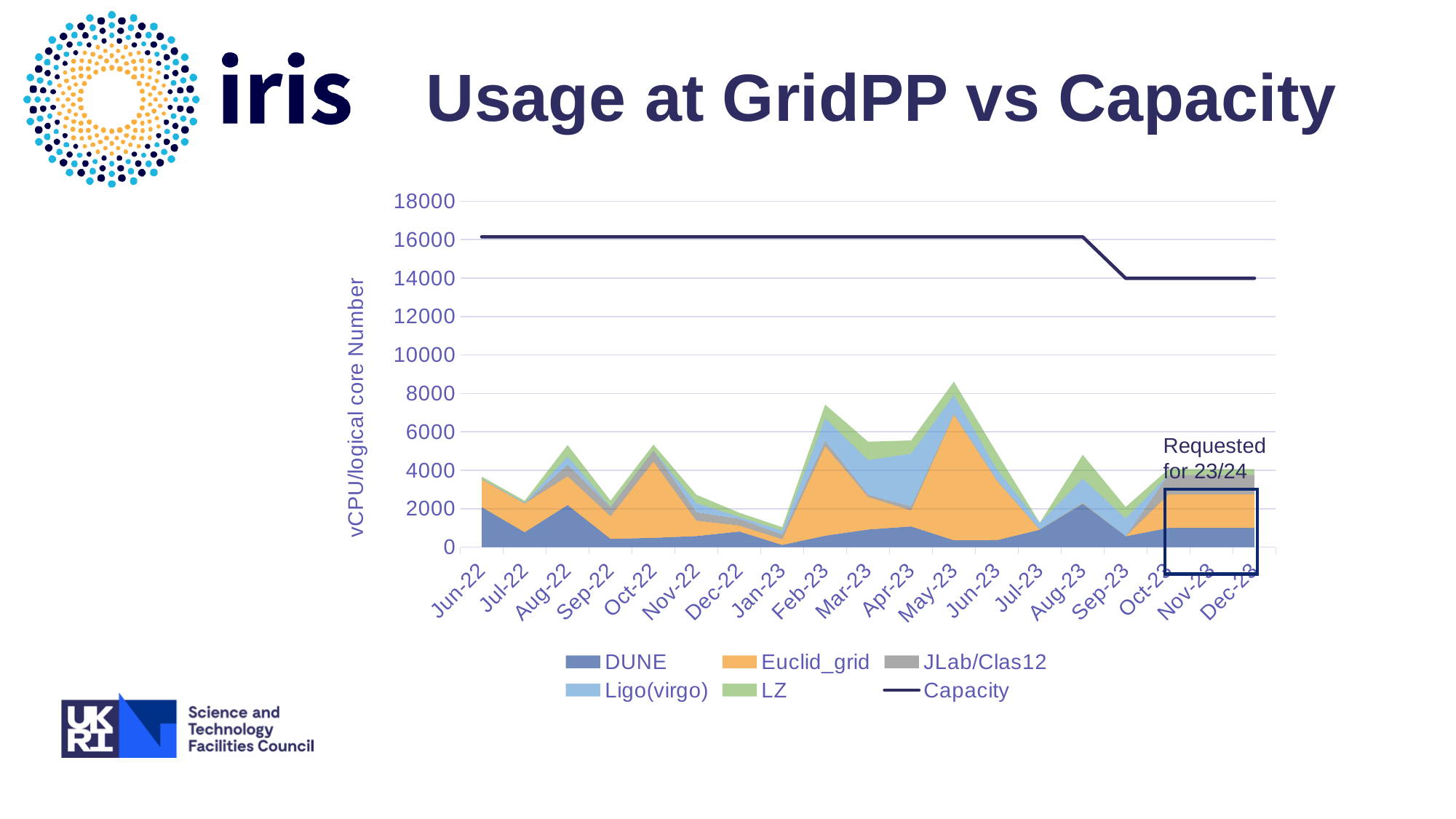
Is the Capacity value in Jun-22 greater or less than 15000? greater In which month does the total usage reach its highest peak? May-23 Is the total usage in Jan-23 greater or less than 2000? less What kind of chart is shown on the slide? combination area and line chart Which month has the larger total usage, Feb-23 or Jul-23? Feb-23 How many months are shown along the x axis? 19 In which month is the total usage lowest? Jan-23 Does the Capacity line rise or fall between Aug-23 and Oct-23? fall What is the label on the y axis? vCPU/logical core Number Is the Capacity value in Dec-23 greater or less than 15000? less How many series does the legend list? 6